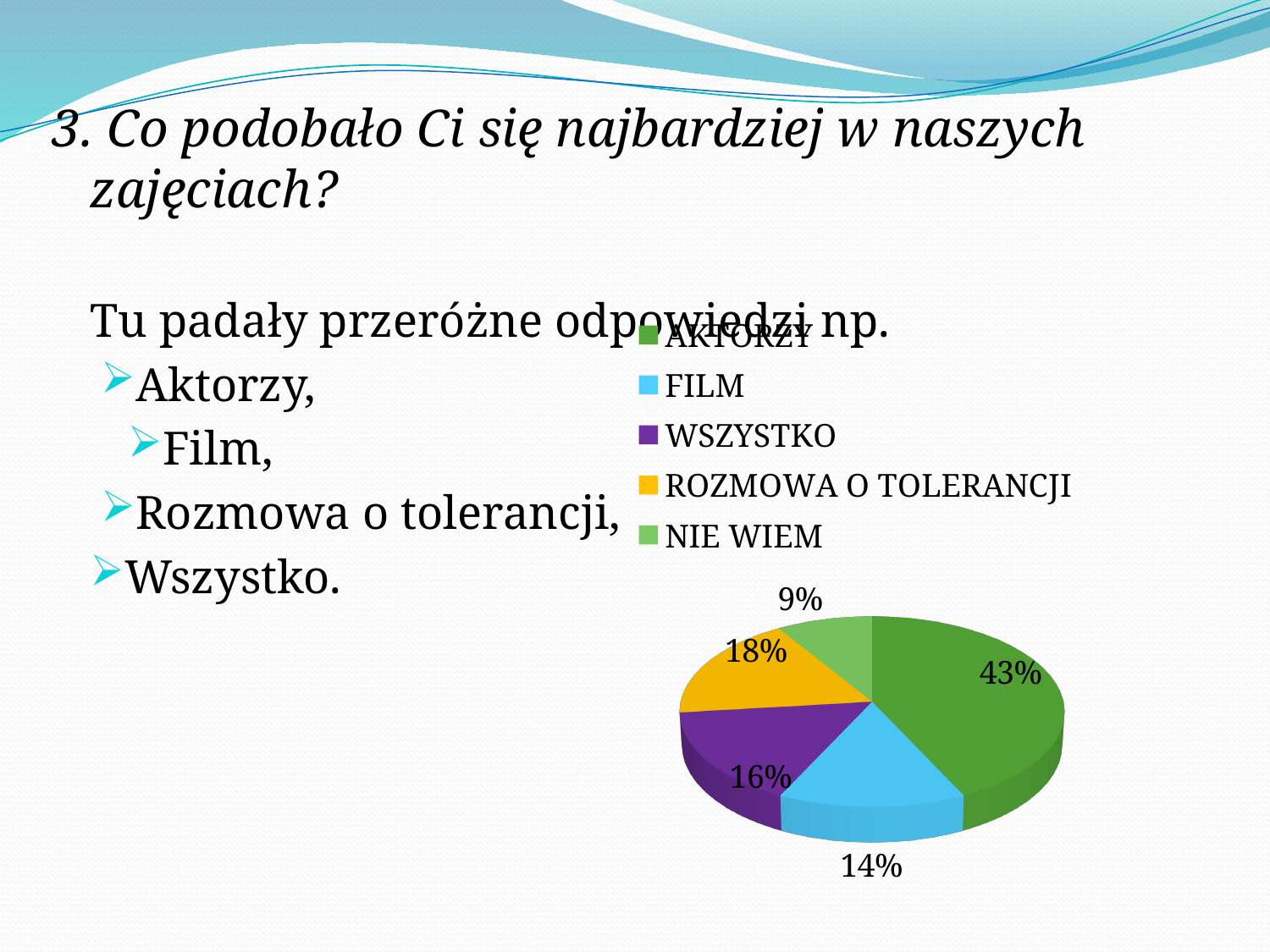
How many categories does the legend of the pie chart list? 5 What kind of chart is shown on the slide? pie chart What is the difference between the shares of AKTORZY and ROZMOWA O TOLERANCJI? 25% What share of the pie does AKTORZY have? 43% Which category has the smallest slice of the pie? NIE WIEM What share of the pie does ROZMOWA O TOLERANCJI have? 18% Which category has the largest slice of the pie? AKTORZY What share of the pie does NIE WIEM have? 9% What colour is the slice for ROZMOWA O TOLERANCJI? yellow Which is larger, the share for WSZYSTKO or the share for FILM? WSZYSTKO